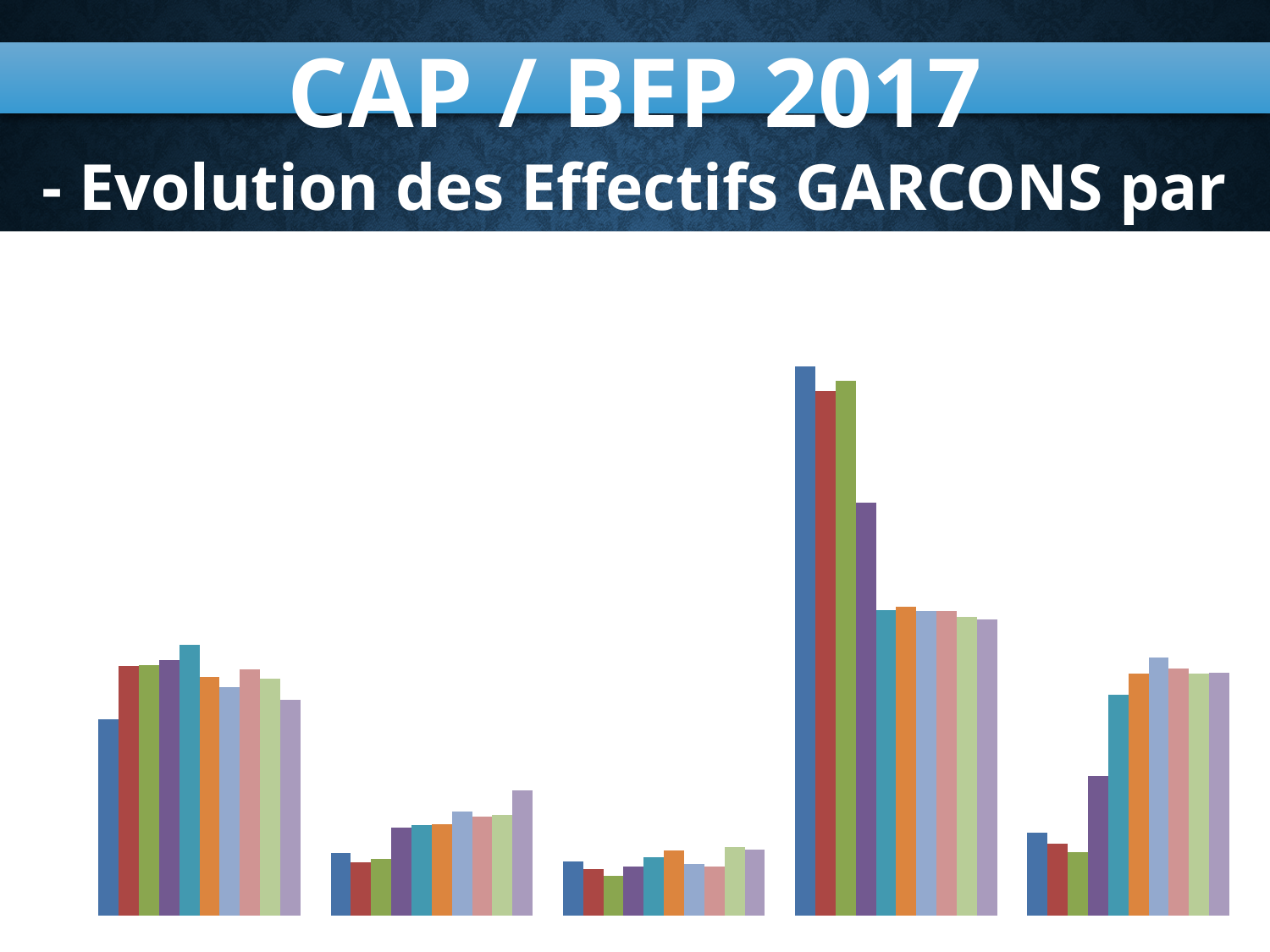
Are the bars in the first group from the left taller or shorter than the bars in the second group? taller Within the fifth group from the left, do the bars generally rise or fall from left to right? rise Within the fourth group from the left, do the bars generally rise or fall from left to right? fall How many groups of bars does the chart contain? 5 Which group of bars, counting from the left, contains the tallest bars in the chart? the fourth group What is the main title shown at the top of the slide? CAP / BEP 2017 What kind of chart is shown on the slide? bar chart What colour is the tallest bar in the fourth group from the left? blue Which group of bars, counting from the left, contains the shortest bars in the chart? the third group How many bars are in each group of the chart? 10 Are the bars in the fourth group from the left taller or shorter than the bars in the fifth group? taller